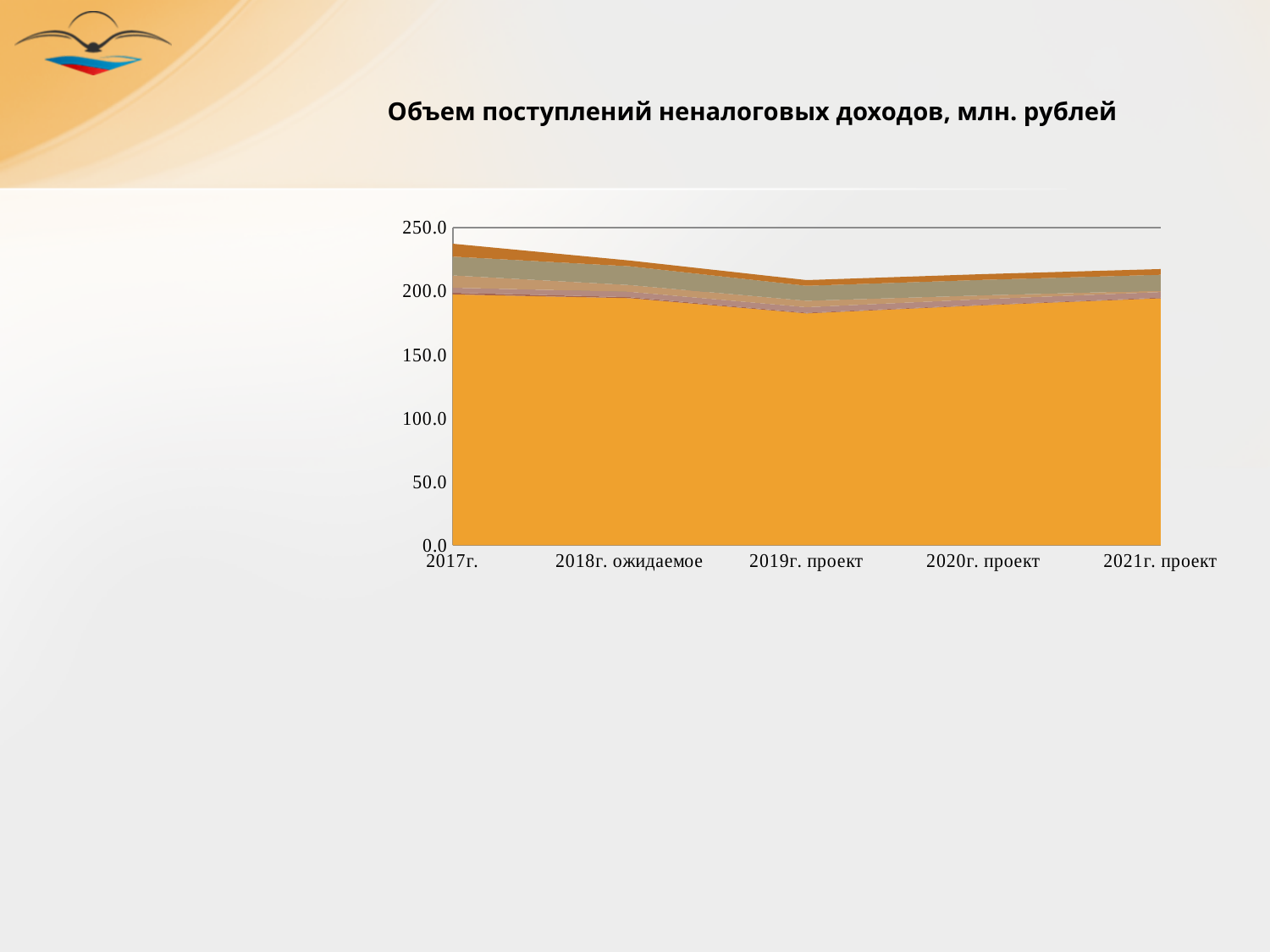
Which has the larger total stacked value, 2017г. or 2019г. проект? 2017г. What is the title of the chart? Объем поступлений неналоговых доходов, млн. рублей Is the value of the bottom (orange) series for 2017г. greater or less than 150? greater Is the total stacked value for 2017г. greater or less than 200? greater How many categories are shown along the x axis? 5 Does the total stacked value rise or fall from 2017г. to 2019г. проект? fall Is the value of the bottom (orange) series for 2019г. проект greater or less than 200? less What kind of chart is shown on the slide? area chart In which category is the total stacked value lowest? 2019г. проект What is the label of the first category on the x axis? 2017г. In which category is the total stacked value highest? 2017г.